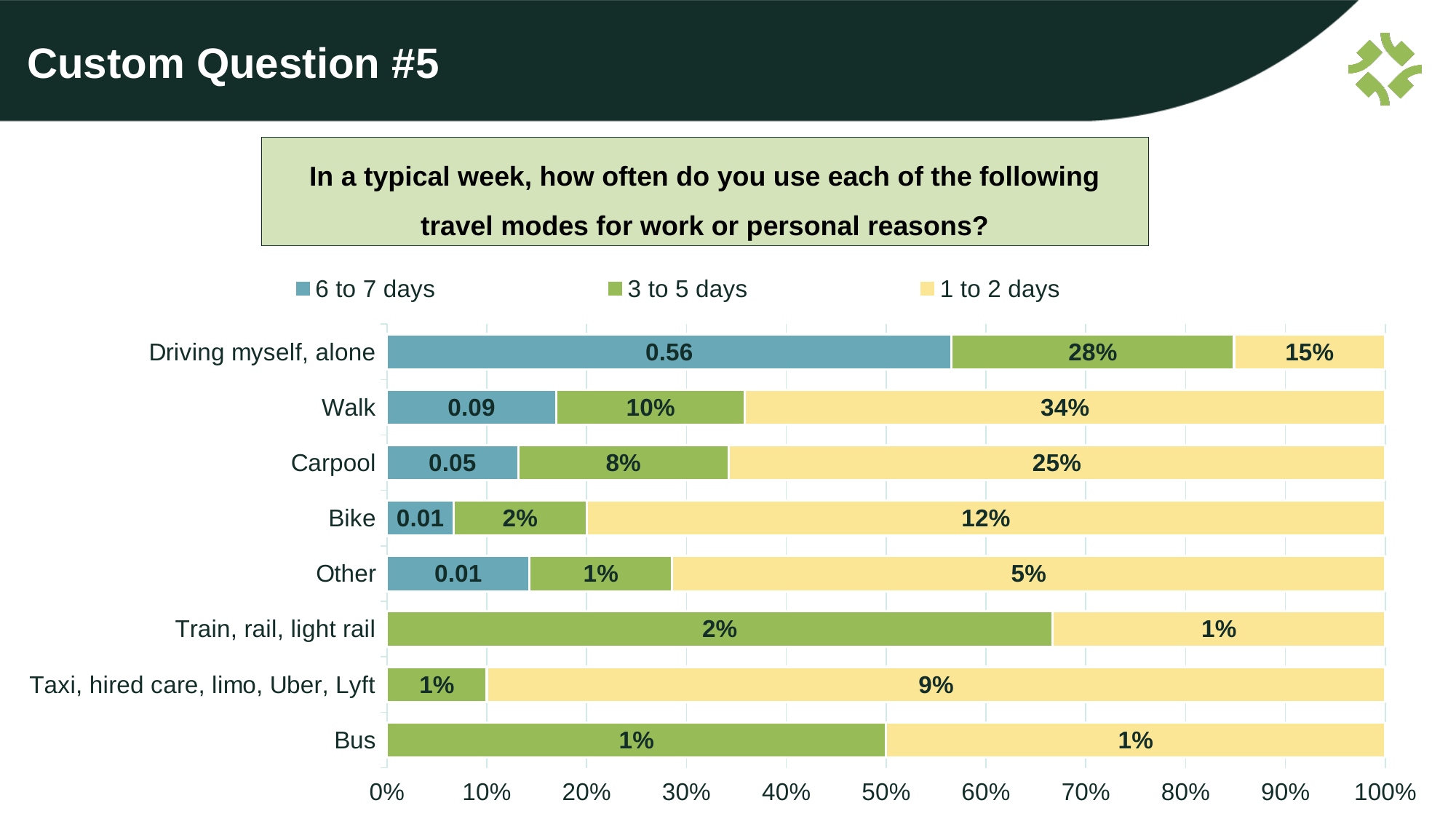
Which travel mode has the highest labelled value for '3 to 5 days'? Driving myself, alone Which legend entry is shown in blue? 6 to 7 days How many travel mode categories are shown on the chart? 8 What type of chart is shown on the slide? Stacked bar chart What is the labelled value for '1 to 2 days' for 'Walk'? 34% What is the labelled value for '6 to 7 days' for 'Carpool'? 0.05 Which is larger: the '1 to 2 days' value for 'Walk' or for 'Carpool'? Walk What is the labelled value for '3 to 5 days' for 'Driving myself, alone'? 28% How many series does the legend list? 3 Which travel mode has the highest labelled value for '1 to 2 days'? Walk What is the difference between the '1 to 2 days' values for 'Walk' and 'Carpool'? 9% What is the labelled value for '1 to 2 days' for 'Taxi, hired care, limo, Uber, Lyft'? 9%